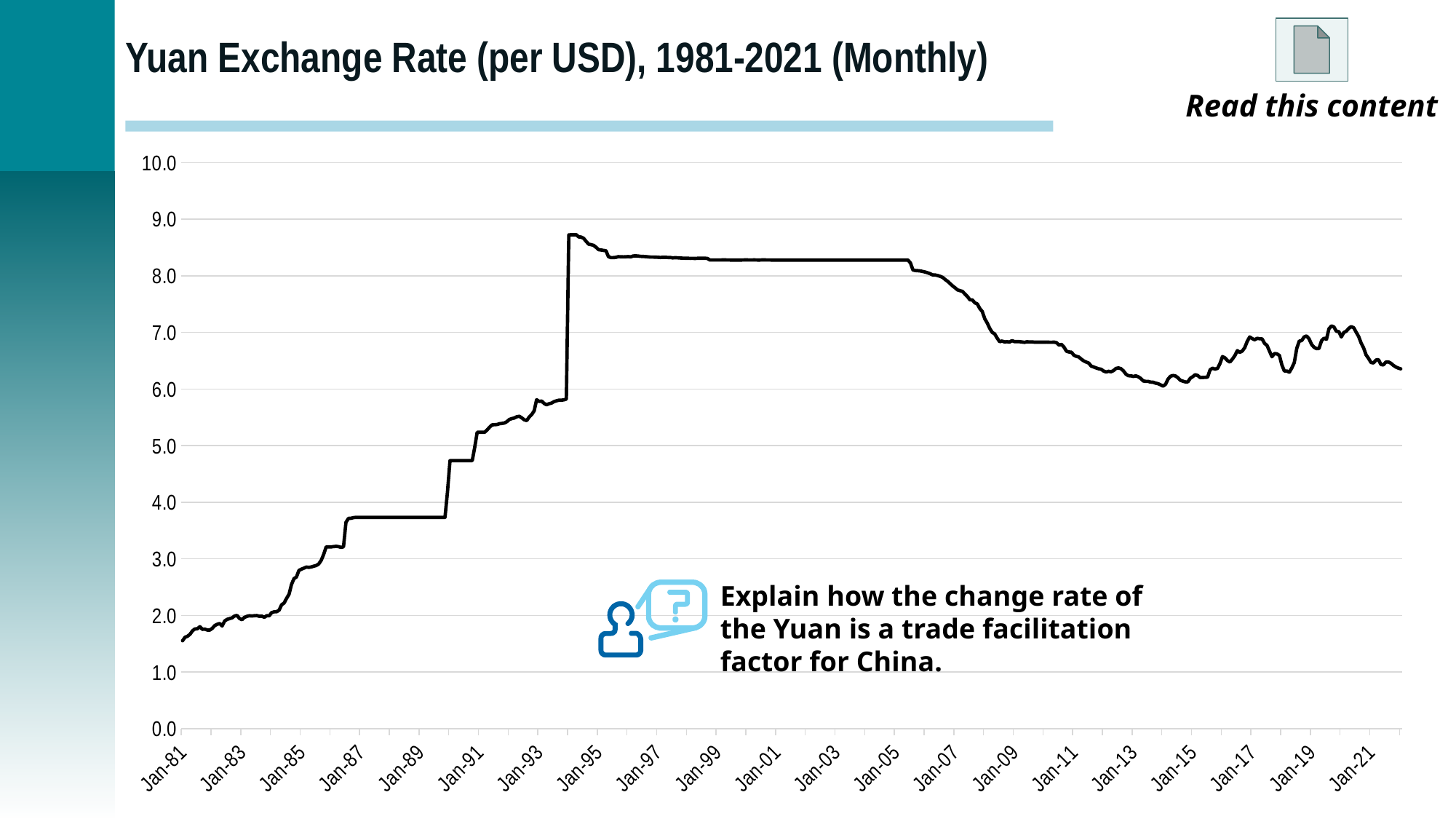
Which is larger, the value at Jan-87 or the value at Jan-91? Jan-91 What kind of chart is shown on the slide? Line chart Is the value at Jan-87 greater or less than 3.0? greater Is the value at Jan-21 greater or less than 6.0? greater Does the exchange rate rise or fall between Jan-05 and Jan-13? Fall Is the value at Jan-99 greater or less than 8.0? greater Does the exchange rate rise or fall between Jan-81 and Jan-95? Rise What is the title of the chart? Yuan Exchange Rate (per USD), 1981-2021 (Monthly) Which is larger, the value at Jan-99 or the value at Jan-21? Jan-99 How many labelled points are there on the x axis? 21